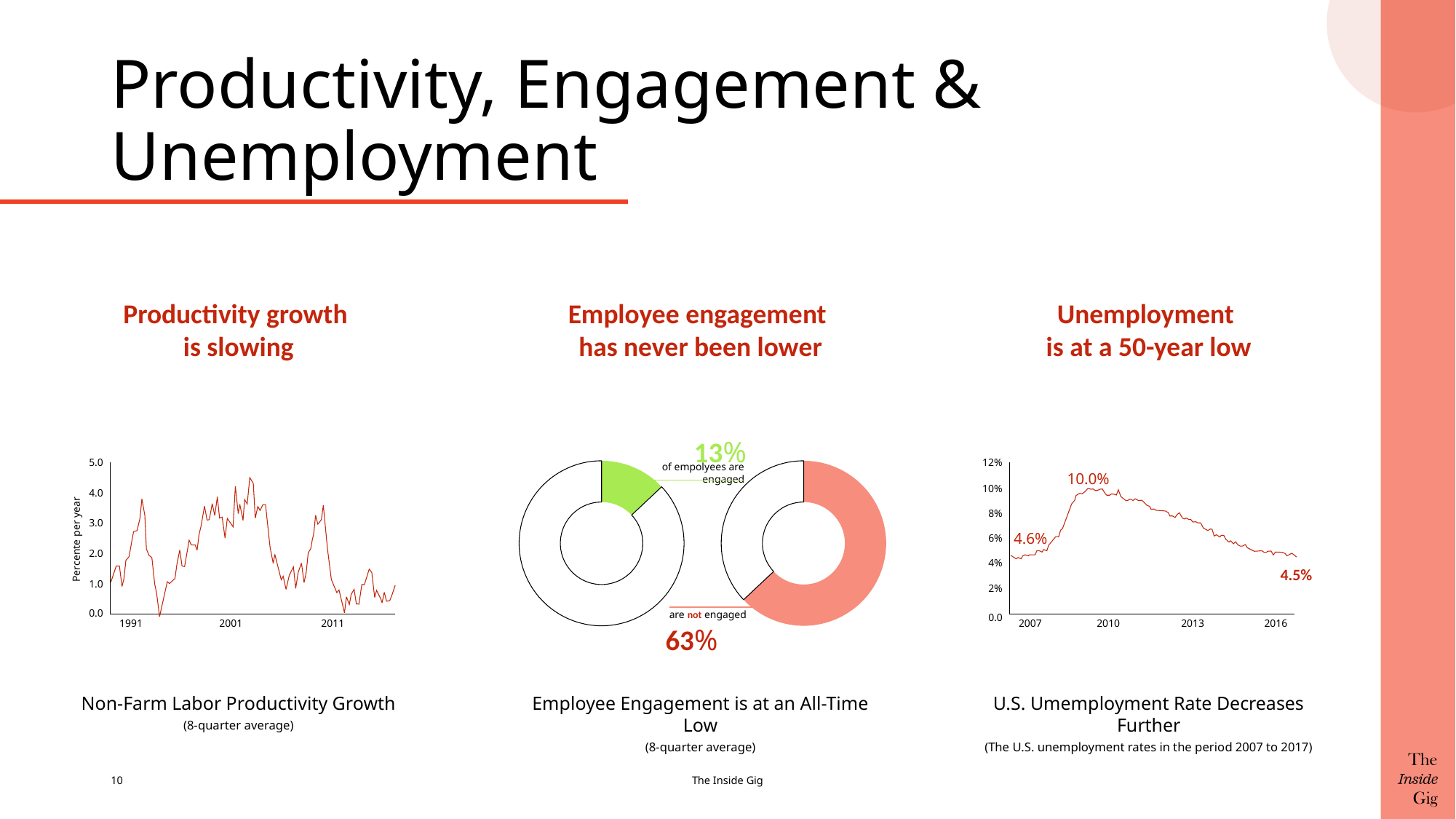
On the Employee Engagement chart, what percentage of employees are engaged? 13% On the Employee Engagement chart, which share is larger: engaged or not engaged? not engaged On the U.S. Unemployment Rate chart, what is the final labelled unemployment rate? 4.5% On the U.S. Unemployment Rate chart, what is the peak unemployment rate labelled? 10.0% On the Non-Farm Labor Productivity Growth chart, is the value at 2001 greater or less than 3.0? greater On the U.S. Unemployment Rate chart, what is the difference between the peak rate of 10.0% and the final rate of 4.5%? 5.5% On the U.S. Unemployment Rate chart, is the value at 2013 greater or less than 6%? greater On the U.S. Unemployment Rate chart, does the line rise or fall from 2010 to 2016? fall On the Employee Engagement chart, what percentage of employees are not engaged? 63% What kind of chart is the Non-Farm Labor Productivity Growth chart on the left? line chart On the Non-Farm Labor Productivity Growth chart, does the line generally rise or fall from 2001 to the end of the series? fall On the Non-Farm Labor Productivity Growth chart, what is the label of the y axis? Percente per year